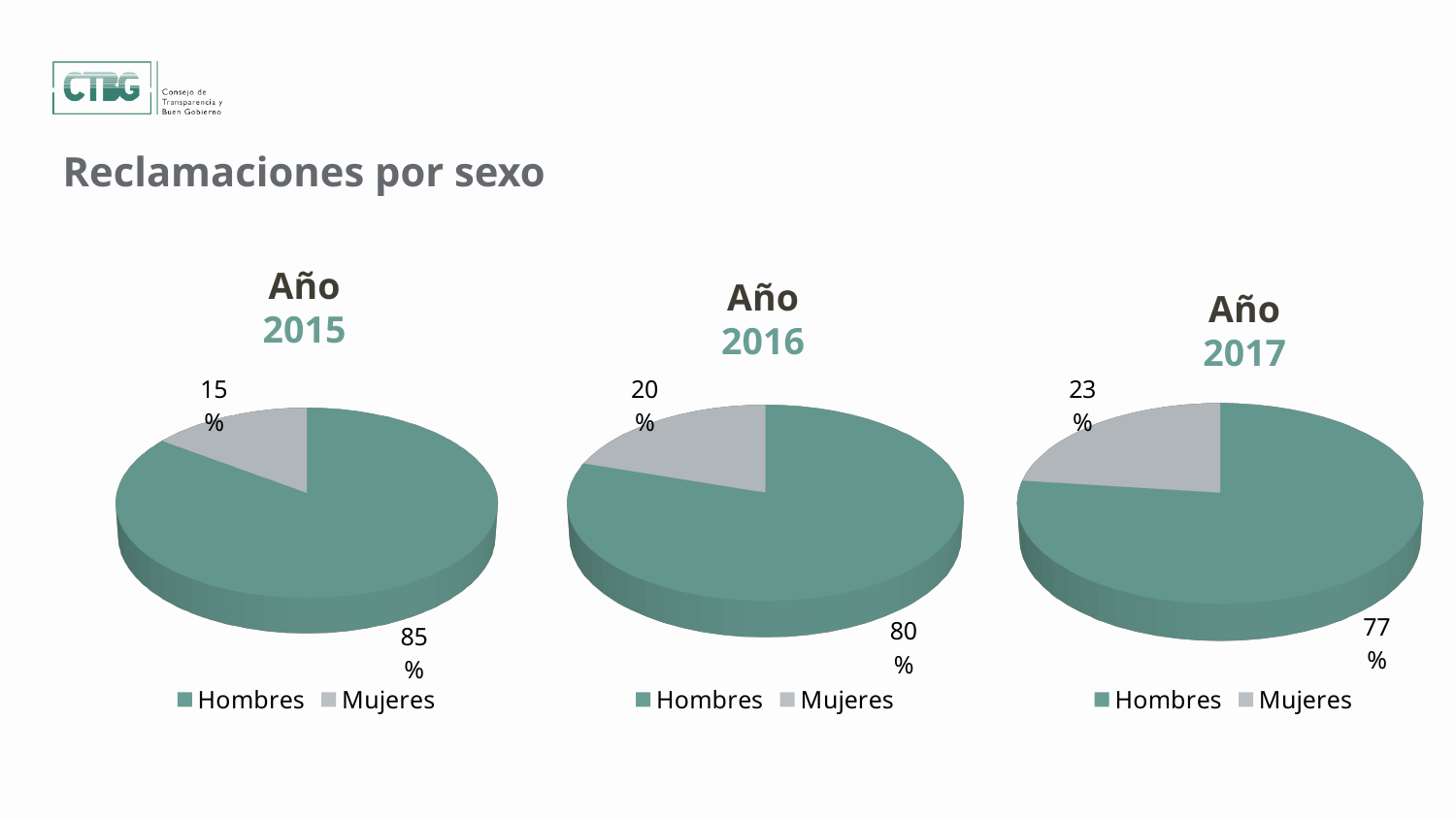
In the Año 2017 chart, what is the value for Hombres? 77% In the Año 2017 chart, what is the difference between the Hombres and Mujeres values? 54% Across the three charts from 2015 to 2017, does the Mujeres share rise or fall? Rise In the Año 2015 chart, what is the difference between the Hombres and Mujeres values? 70% In the Año 2016 chart, what is the value for Mujeres? 20% In the Año 2016 chart, which category has the largest slice? Hombres In the Año 2017 chart, which category has the smallest slice? Mujeres In the Año 2015 chart, what is the value for Hombres? 85% In the Año 2017 chart, what is the value for Mujeres? 23% What kind of chart is the Año 2016 chart? Pie chart In the Año 2015 chart, what is the value for Mujeres? 15% How many series does the legend of the Año 2015 chart list? 2